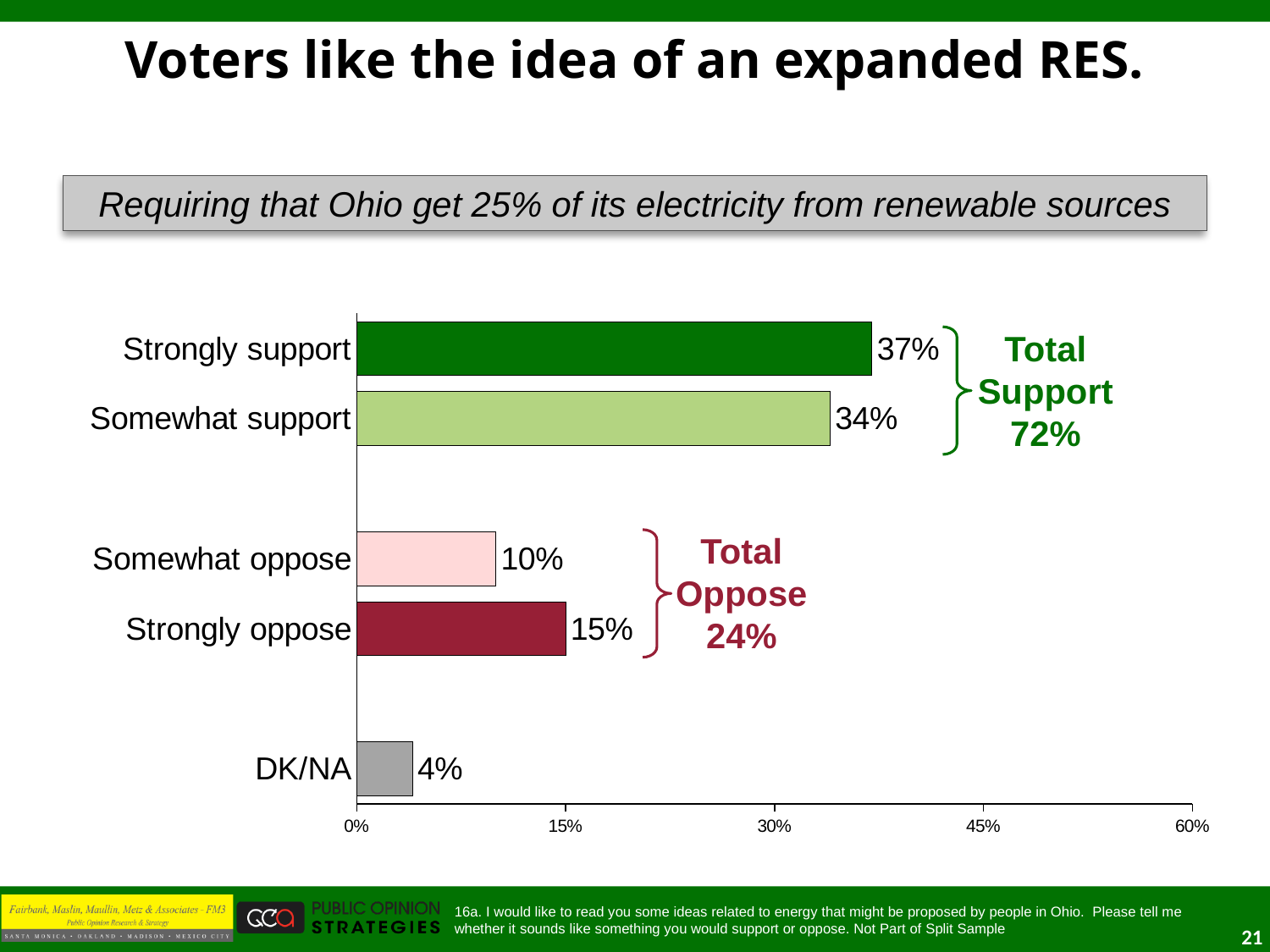
What is the value shown for Strongly oppose? 15% What is the value shown for DK/NA? 4% What is the value shown for Somewhat support? 34% Which response category has the highest value? Strongly support What kind of chart is shown on the slide? Bar chart What Total Support percentage is labeled on the chart? 72% What percentage of voters strongly support requiring that Ohio get 25% of its electricity from renewable sources? 37% Which is larger, Somewhat oppose or Strongly oppose? Strongly oppose What is the difference between Strongly support and Strongly oppose? 22% Which response category has the lowest value? DK/NA Is the value for Somewhat support greater or less than 30%? greater How many response categories are shown in the chart? 5